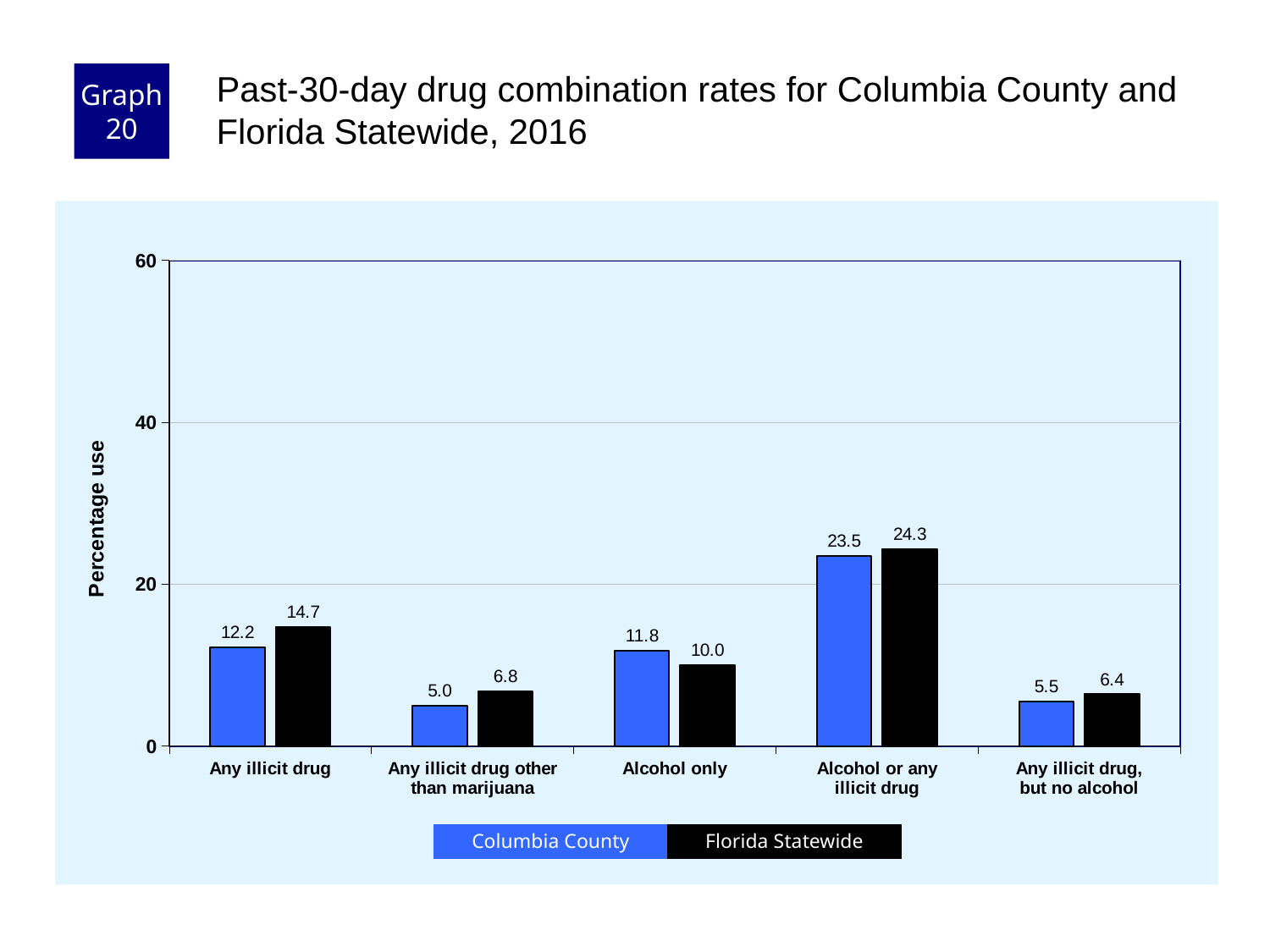
Which category has the lowest Florida Statewide value? Any illicit drug, but no alcohol How many categories are shown on the x axis? 5 How many series does the legend list? 2 What kind of chart is shown on the slide? bar chart Which category has the highest Columbia County value? Alcohol or any illicit drug What is the Columbia County value for Any illicit drug? 12.2 What is the Florida Statewide value for Alcohol only? 10.0 What is the Florida Statewide value for Any illicit drug other than marijuana? 6.8 Is the Florida Statewide value for Alcohol or any illicit drug greater or less than 20? greater What is the label of the y axis? Percentage use For Alcohol only, which is larger: Columbia County or Florida Statewide? Columbia County What is the difference between the Florida Statewide and Columbia County values for Any illicit drug? 2.5